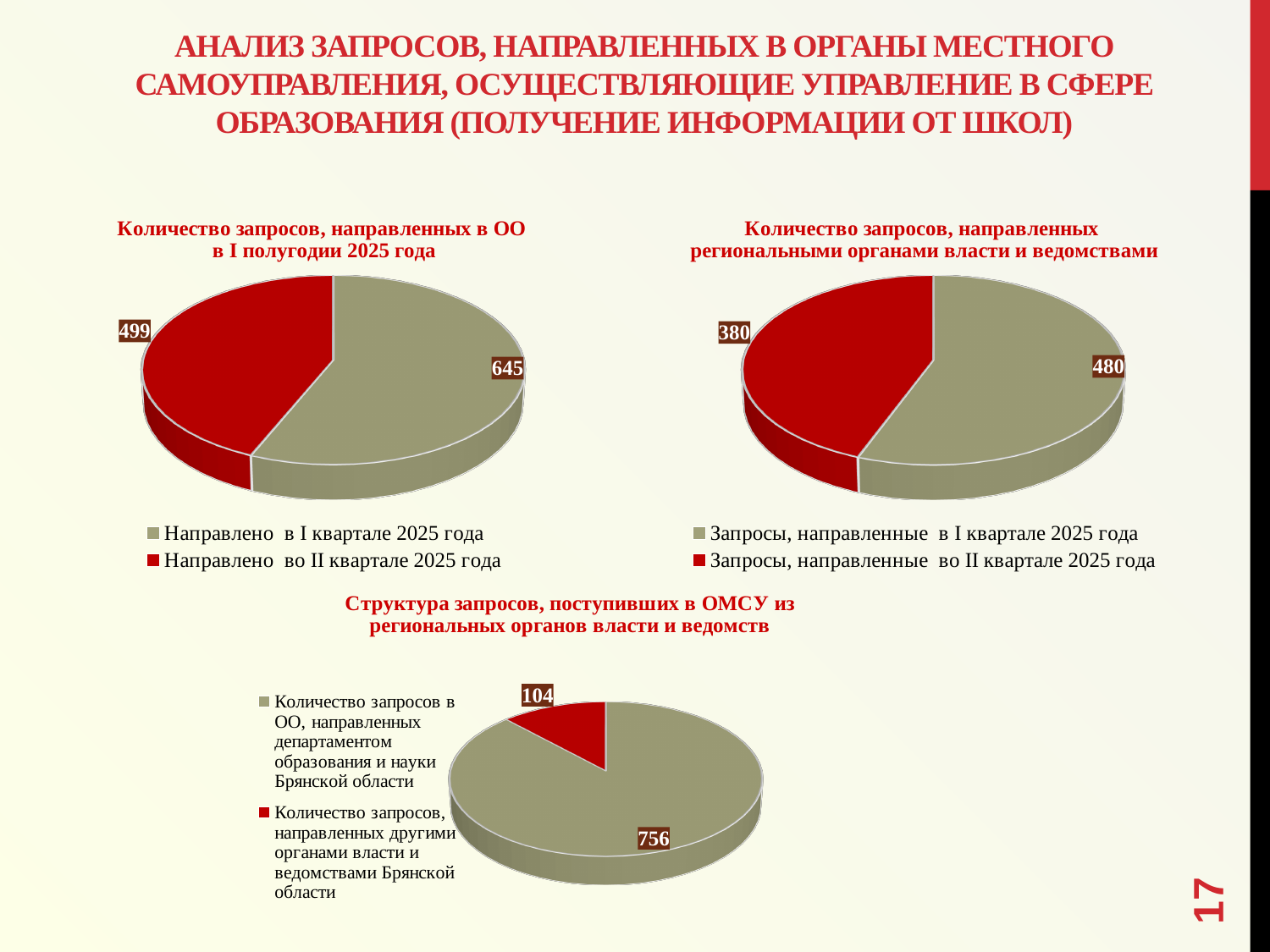
On the bottom chart 'Структура запросов, поступивших в ОМСУ из региональных органов власти и ведомств', how many requests were sent by the department of education and science of the Bryansk region? 756 On the bottom chart 'Структура запросов, поступивших в ОМСУ из региональных органов власти и ведомств', what share of the total do the 104 requests from other authorities represent? 12.1% On the top-right chart 'Количество запросов, направленных региональными органами власти и ведомствами', what is the total of the two slices? 860 On the top-left chart 'Количество запросов, направленных в ОО в I полугодии 2025 года', how many requests were sent in the I quarter of 2025? 645 On the bottom chart 'Структура запросов, поступивших в ОМСУ из региональных органов власти и ведомств', what is the difference between the two slices? 652 On the top-left chart 'Количество запросов, направленных в ОО в I полугодии 2025 года', how many requests were sent in the II quarter of 2025? 499 On the top-right chart 'Количество запросов, направленных региональными органами власти и ведомствами', how many requests were sent in the II quarter of 2025? 380 What type of chart is used for the top-left chart 'Количество запросов, направленных в ОО в I полугодии 2025 года'? Pie chart On the bottom chart 'Структура запросов, поступивших в ОМСУ из региональных органов власти и ведомств', which category has the smallest slice? Количество запросов, направленных другими органами власти и ведомствами Брянской области On the top-right chart 'Количество запросов, направленных региональными органами власти и ведомствами', which quarter has the larger value? I квартал 2025 года On the top-left chart 'Количество запросов, направленных в ОО в I полугодии 2025 года', what is the difference between the I quarter and II quarter values? 146 How many charts are shown on the slide? 3